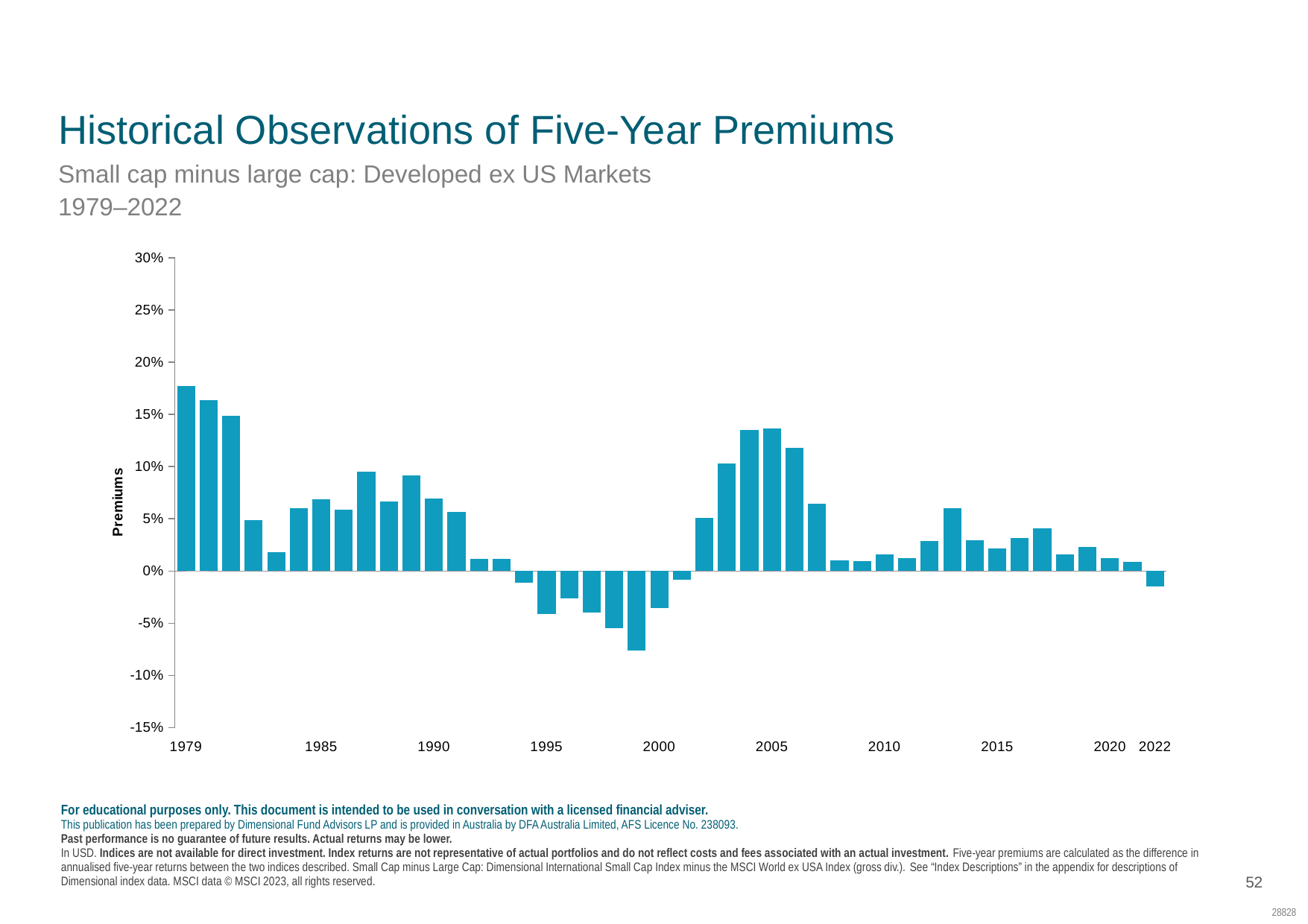
Which year has the lowest five-year premium in the chart? 1999 What is the label on the vertical axis of the chart? Premiums How many years (bars) are plotted in the chart? 44 Do the premiums rise or fall from 1979 to 1983? fall Is the value for 1979 greater or less than 15%? greater Is the value for 2022 greater or less than 0%? less Is the value for 1999 greater or less than -5%? less Which year has the highest five-year premium in the chart? 1979 Which year has the larger premium, 1979 or 2005? 1979 Which year has the larger premium, 1987 or 1995? 1987 What kind of chart is shown on the slide? bar chart